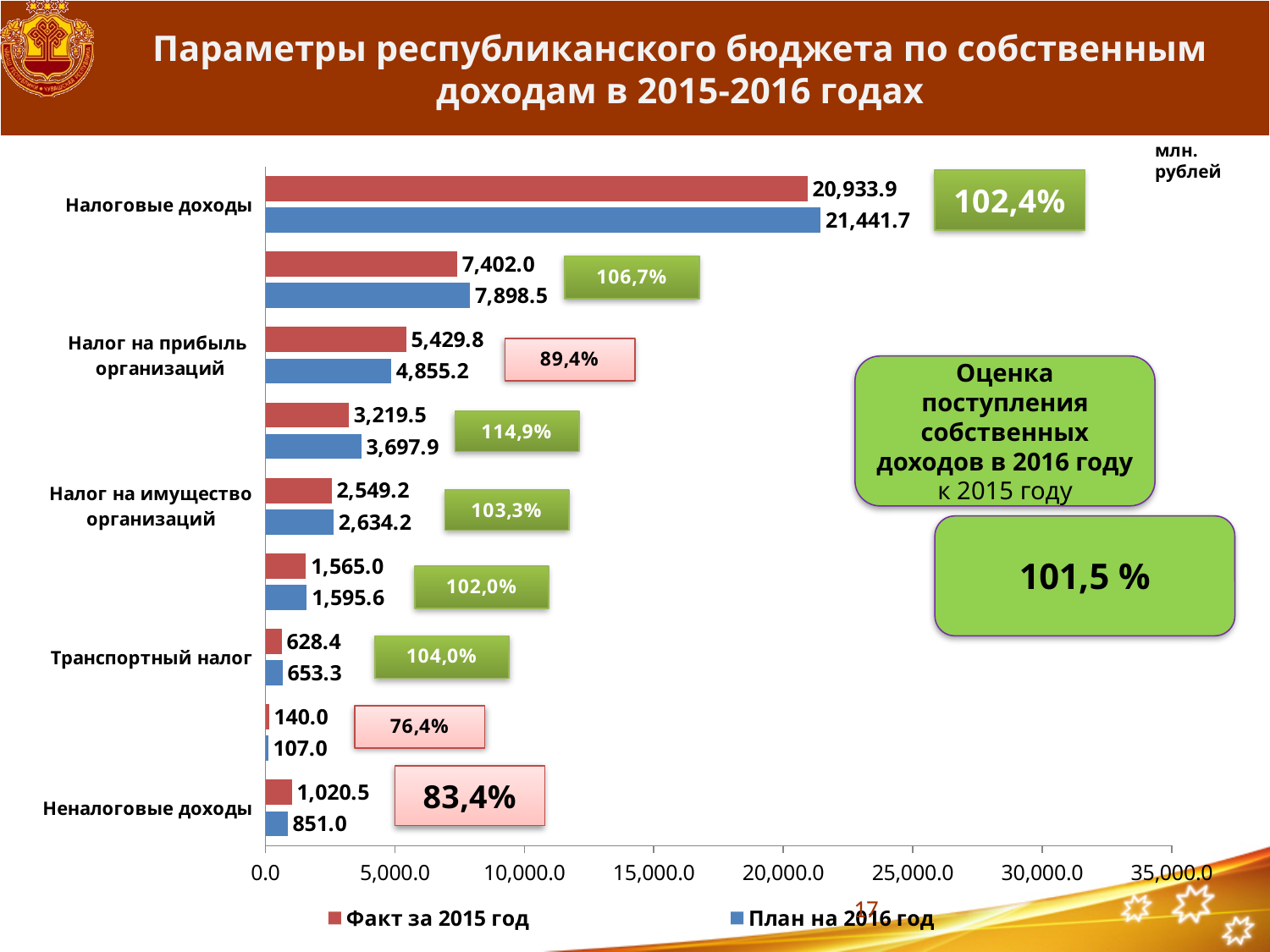
What is the value of План на 2016 год for Налоговые доходы? 21,441.7 What is the value of План на 2016 год for Налог на имущество организаций? 2,634.2 For Налоговые доходы, how much larger is План на 2016 год than Факт за 2015 год? 507.8 Which labelled category has the highest value for План на 2016 год? Налоговые доходы What is the value of Факт за 2015 год for Неналоговые доходы? 1,020.5 What kind of chart is shown on the slide? Bar chart What is the value of Факт за 2015 год for Налоговые доходы? 20,933.9 For Налог на прибыль организаций, which is larger: Факт за 2015 год or План на 2016 год? Факт за 2015 год How many series does the legend list? 2 What is the value of План на 2016 год for Транспортный налог? 653.3 For Неналоговые доходы, what is the difference between Факт за 2015 год and План на 2016 год? 169.5 What is the value of Факт за 2015 год for Налог на прибыль организаций? 5,429.8